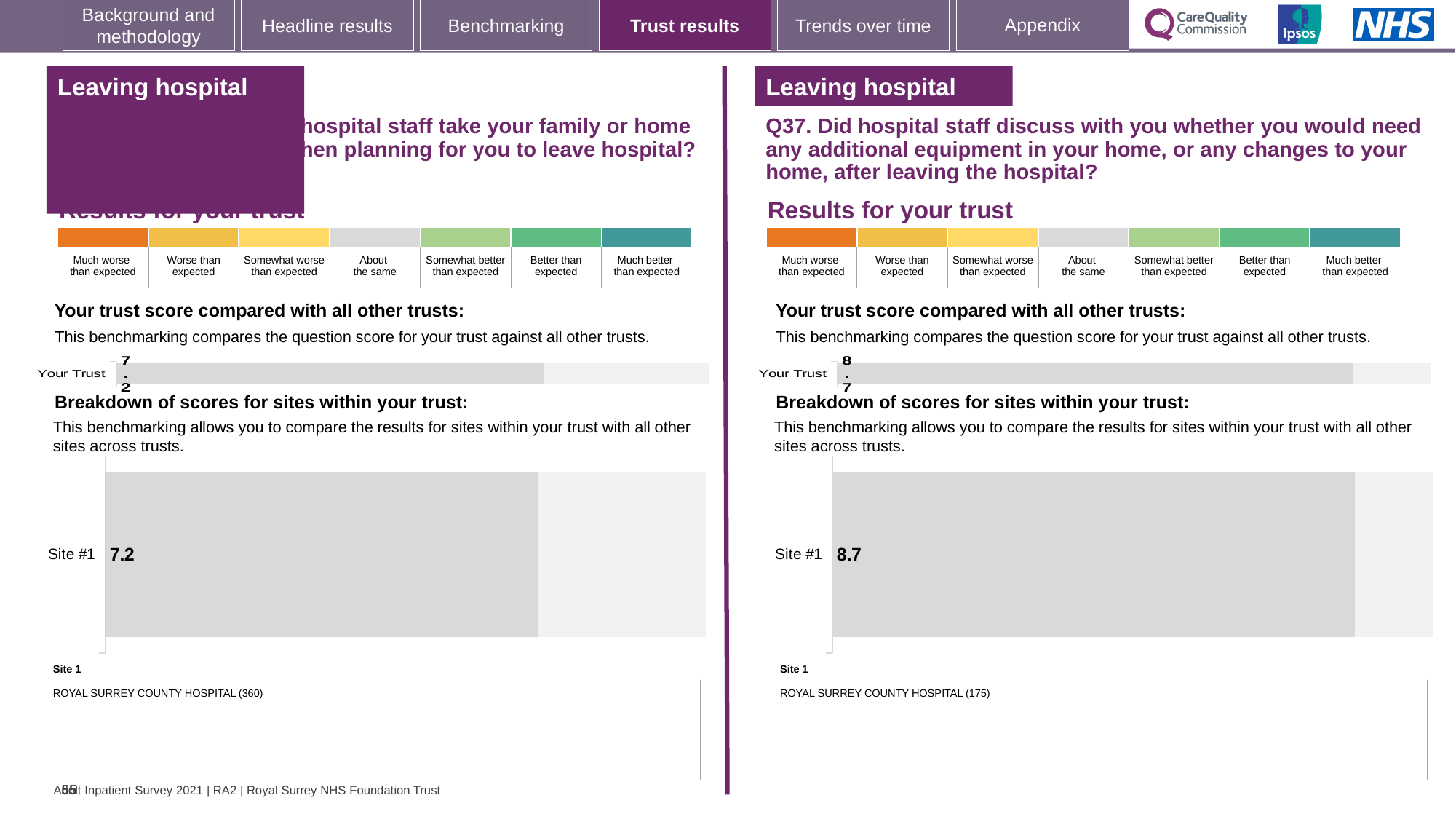
On the left half of the slide, what is the score shown for Your Trust in the 'Your trust score compared with all other trusts' chart? 7.2 Which is larger: the Site #1 score in the left chart or the Site #1 score in the right (Q37) chart? The right (Q37) chart Is the Your Trust score on the left half of the slide greater or less than 8? less What kind of chart is used to show the Site #1 score on the left half of the slide? Bar chart On the left half of the slide, which hospital is listed as Site 1? ROYAL SURREY COUNTY HOSPITAL (360) On the right half of the slide (Q37), what score is shown for Site #1 in the 'Breakdown of scores for sites within your trust' chart? 8.7 On the right half of the slide (Q37), which hospital is listed as Site 1? ROYAL SURREY COUNTY HOSPITAL (175) Is the Your Trust score on the right half of the slide (Q37) greater or less than 8? greater How many sites are shown in the 'Breakdown of scores for sites within your trust' chart on the right half of the slide (Q37)? 1 On the right half of the slide (Q37), what is the score shown for Your Trust in the 'Your trust score compared with all other trusts' chart? 8.7 On the left half of the slide, what score is shown for Site #1 in the 'Breakdown of scores for sites within your trust' chart? 7.2 What is the difference between the Site #1 score on the right (Q37) chart and the Site #1 score on the left chart? 1.5